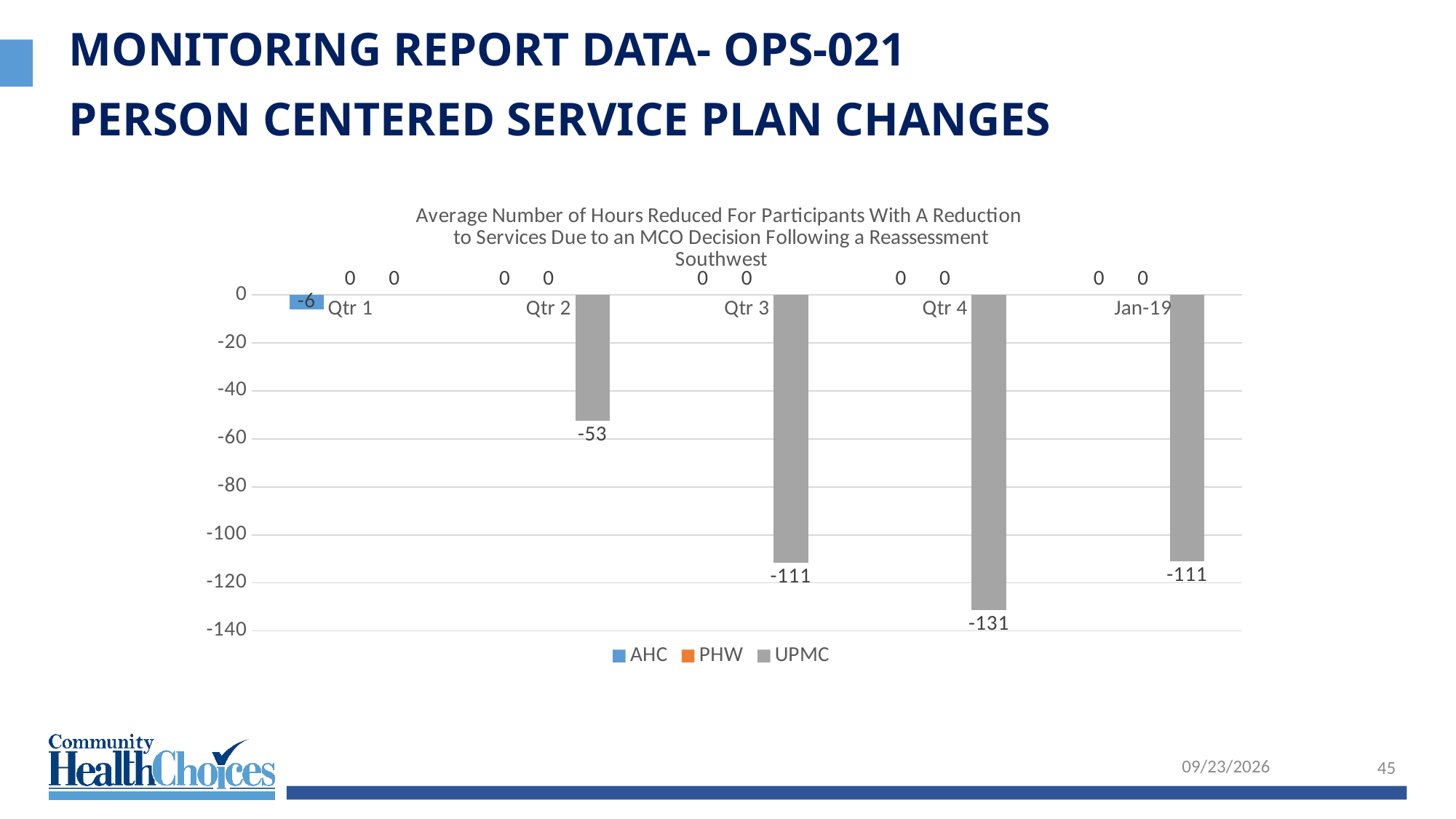
What is the value for UPMC in Jan-19? -111 What is the difference between the UPMC values for Qtr 4 and Qtr 3? 20 What is the value for UPMC in Qtr 2? -53 What is the value for UPMC in Qtr 4? -131 Which series is shown in gray in the legend? UPMC What is the value for AHC in Qtr 1? -6 In which category does UPMC have its lowest (most negative) value? Qtr 4 How many categories are shown on the x axis? 5 What is the value for PHW in Qtr 3? 0 Which is lower (more negative), the UPMC value for Qtr 2 or for Qtr 3? Qtr 3 How many series does the legend list? 3 What kind of chart is shown on the slide? Bar chart